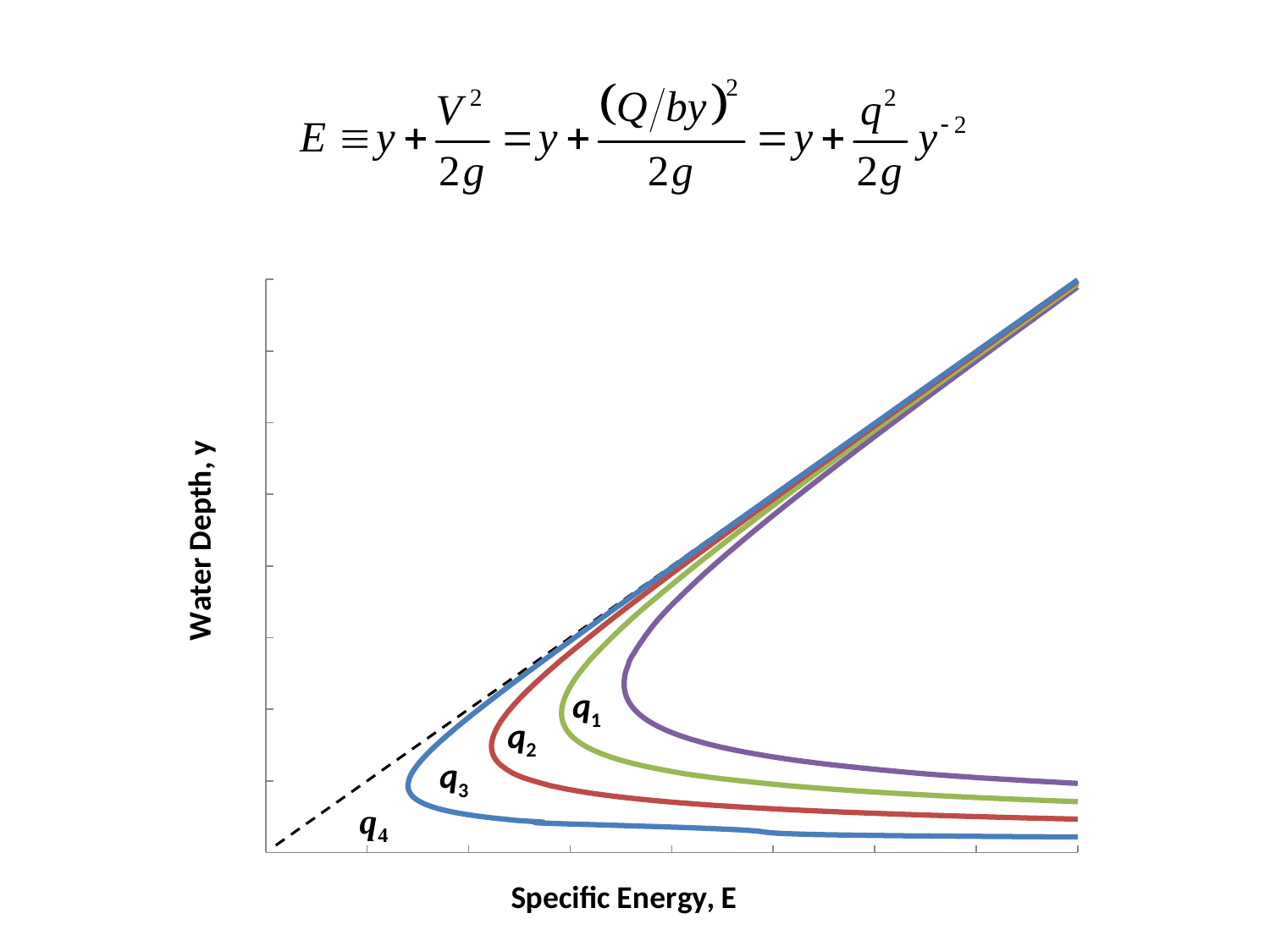
Which coloured curve has its turning point (minimum specific energy) furthest to the left? blue What is the title of the y axis? Water Depth, y How many q labels (q1, q2, q3, q4) appear on the chart? 4 Which coloured curve has its turning point (minimum specific energy) furthest to the right? purple How many solid coloured curves are plotted on the chart? 4 Along the upper branches, does water depth rise or fall as specific energy increases? rise What kind of chart is shown on the slide? line chart At the right edge of the chart, which coloured curve's lower branch has the lowest water depth? blue At the right edge of the chart, is the lower branch of the purple curve higher or lower than the lower branch of the green curve? higher What is the title of the x axis? Specific Energy, E